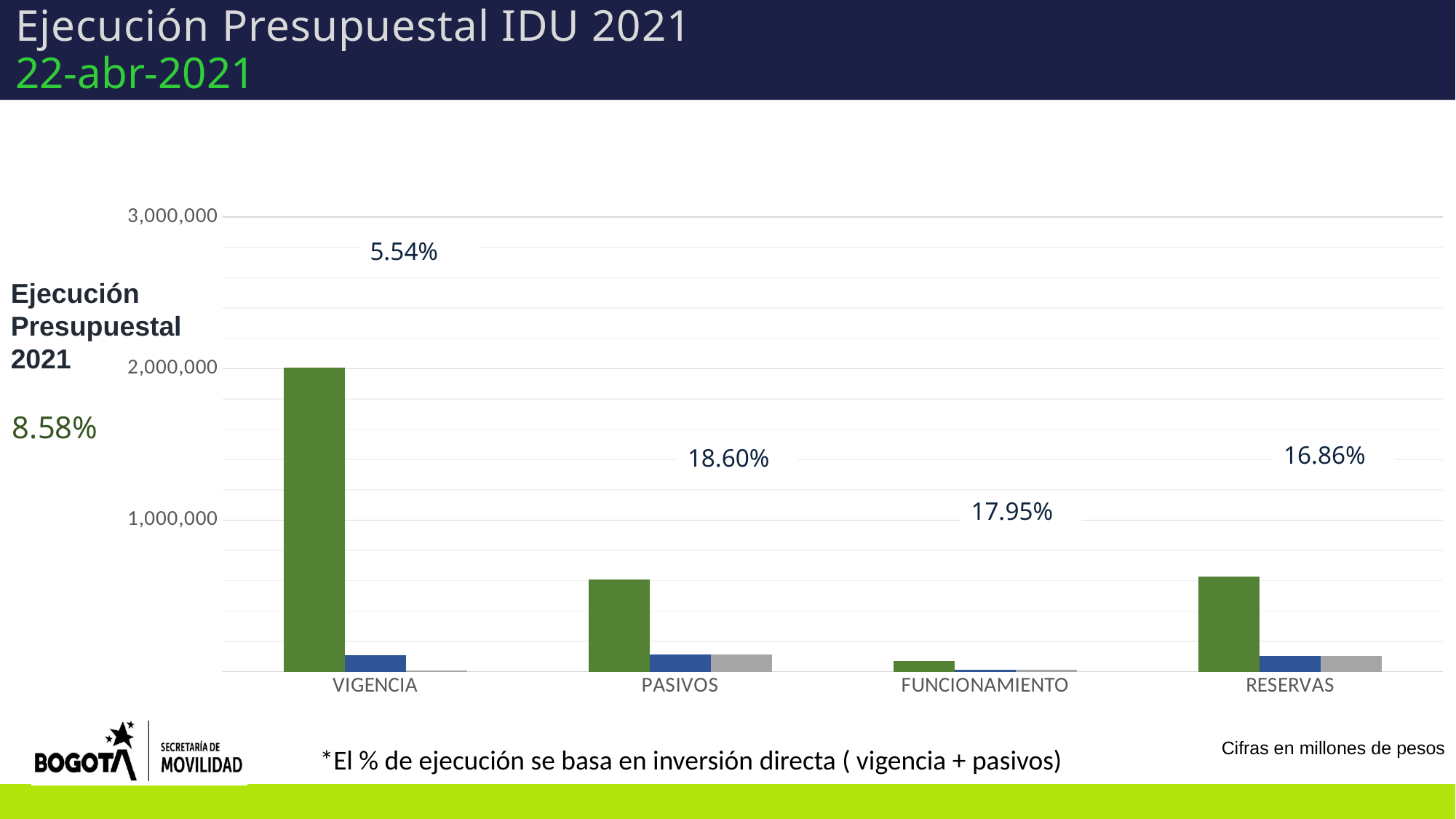
Is the green bar for VIGENCIA greater or less than 1,000,000? greater What kind of chart is shown on the slide? bar chart Which category has the lowest percentage label? VIGENCIA Which category has the highest percentage label? PASIVOS Which category has the tallest green bar? VIGENCIA Which category has the shortest green bar? FUNCIONAMIENTO What percentage label is shown above the RESERVAS category? 16.86% What percentage label is shown above the PASIVOS category? 18.60% What percentage label is shown above the VIGENCIA category? 5.54% What percentage label is shown above the FUNCIONAMIENTO category? 17.95% Is the green bar for PASIVOS greater or less than 1,000,000? less How many categories are shown on the x axis of the chart? 4